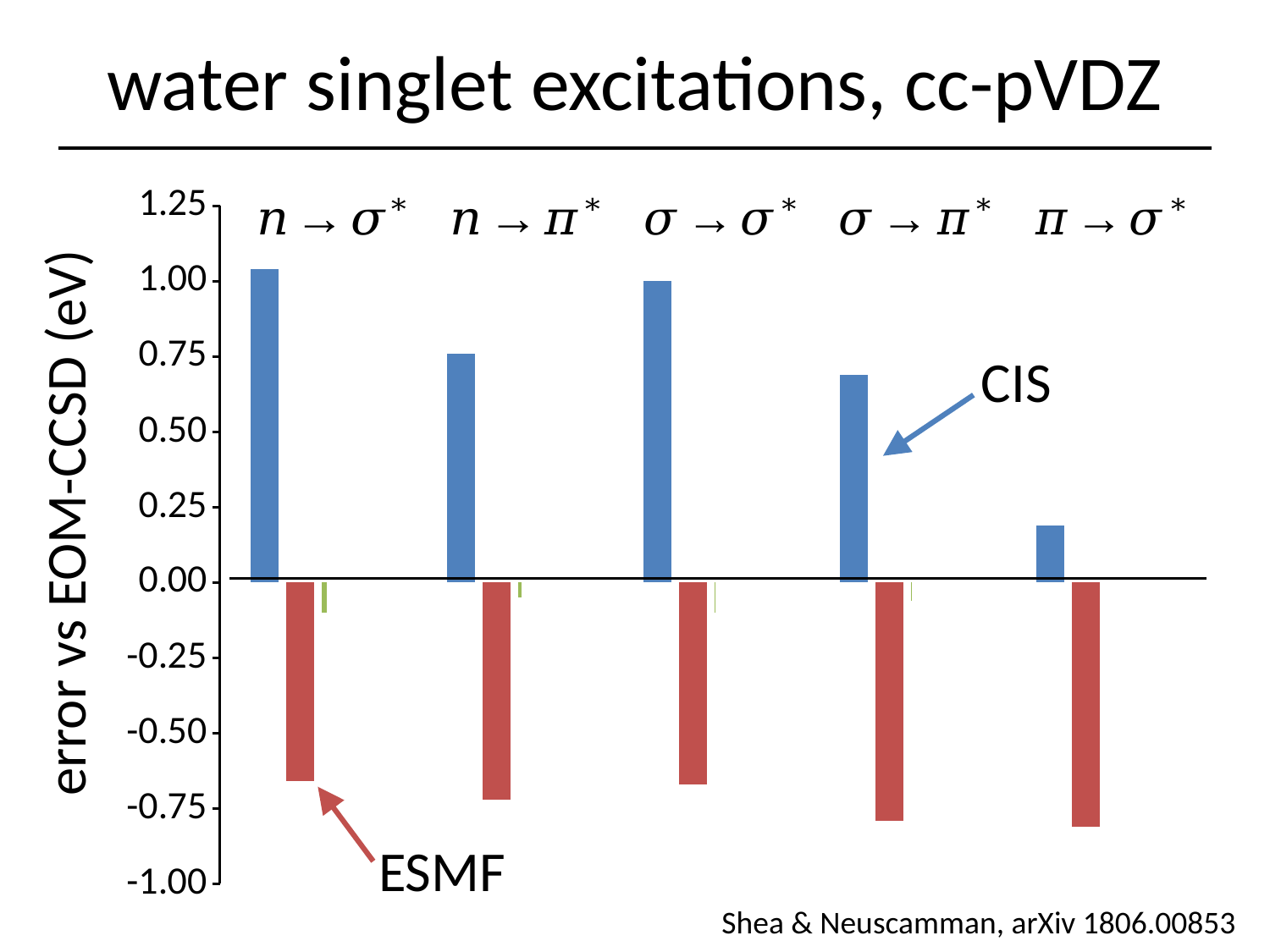
How many excitation categories are shown along the x axis? 5 Is the CIS error for n → σ* greater or less than 1.00 eV? greater Is the ESMF error for n → π* greater or less than -0.50 eV? less Which excitation has the highest CIS error? n → σ* What is the title of the chart? water singlet excitations, cc-pVDZ Which excitation has the lowest CIS error? π → σ* Is the CIS error for σ → π* greater or less than 0.75 eV? less What is the label of the y axis? error vs EOM-CCSD (eV) What kind of chart is shown on the slide? bar chart Which has the larger CIS error, n → σ* or n → π*? n → σ*